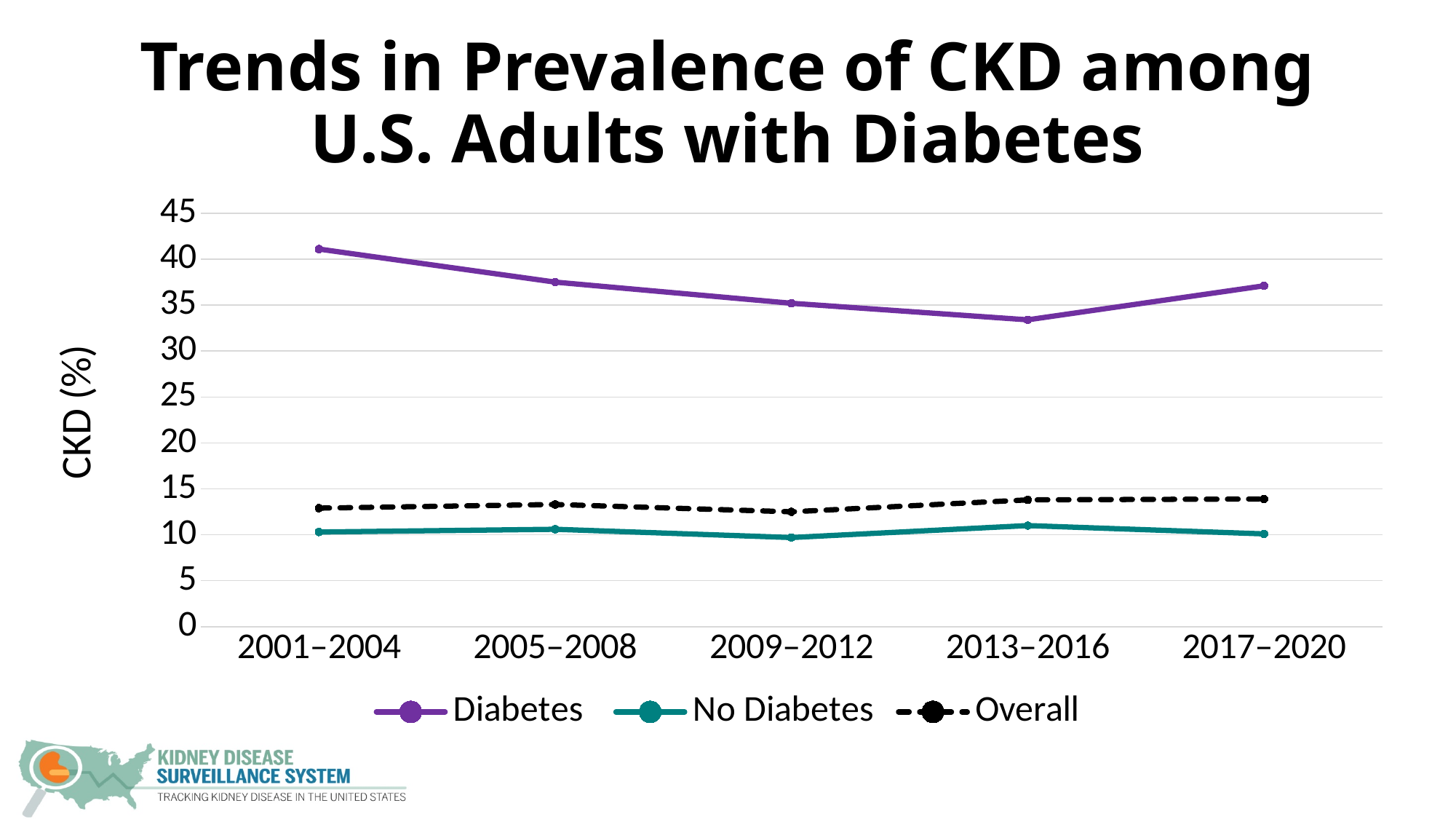
In which period is the Diabetes series at its lowest? 2013–2016 How many series does the legend list? 3 Is the value for Overall in 2017–2020 greater or less than 15? less What is the label on the y axis? CKD (%) Which series has the larger value in 2017–2020, Diabetes or No Diabetes? Diabetes In which period is the Diabetes series at its highest? 2001–2004 Is the value for Diabetes in 2013–2016 greater or less than 35? less Is the value for Diabetes in 2001–2004 greater or less than 40? greater What kind of chart is shown on the slide? line chart How many time periods are shown on the x axis? 5 Does the Diabetes series rise or fall from 2001–2004 to 2013–2016? fall